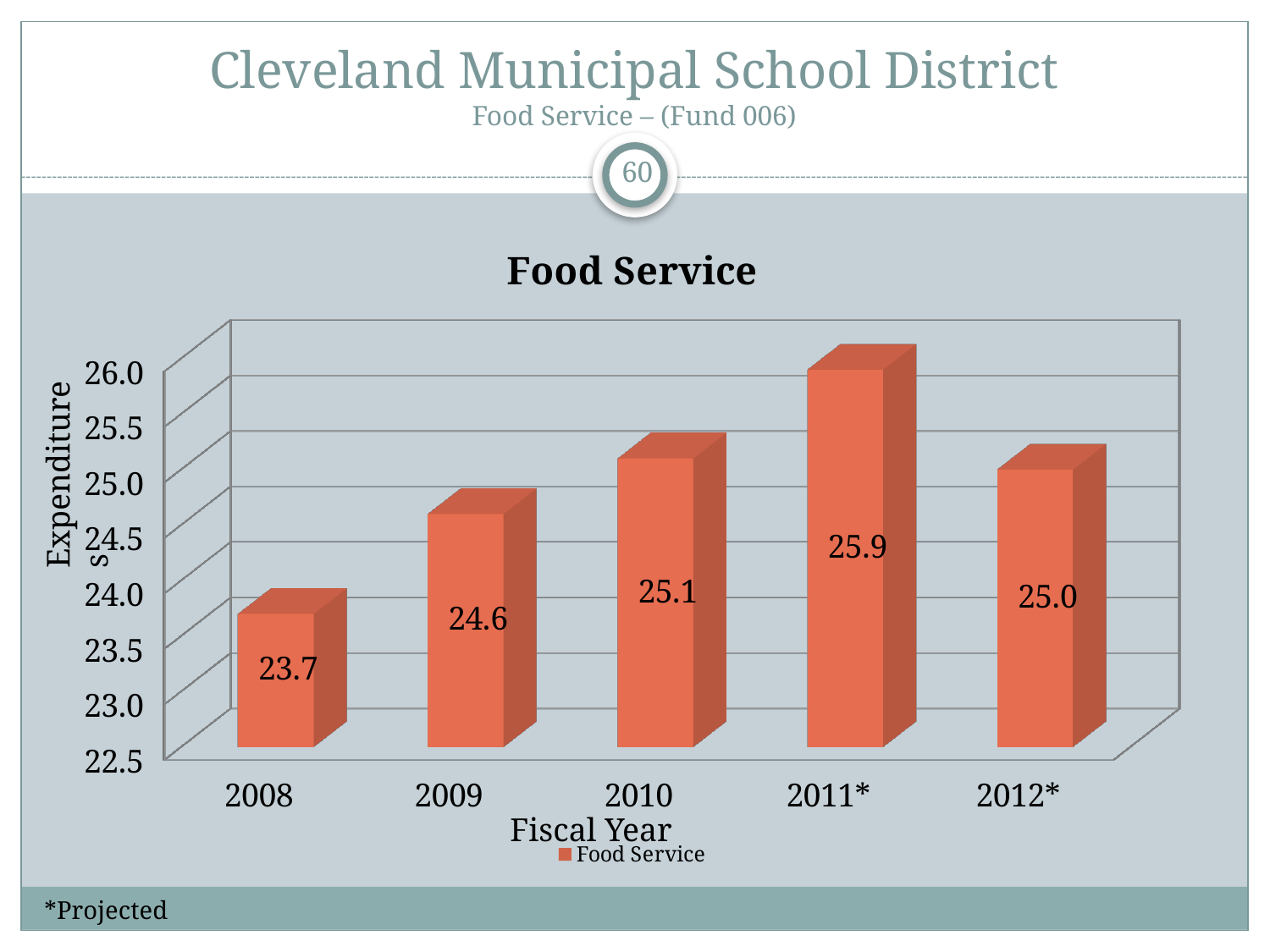
What kind of chart is used to show Food Service expenditure? bar chart What is the difference between the Food Service expenditure in 2009 and in 2010? 0.5 Which fiscal year has the lowest Food Service expenditure? 2008 How many fiscal years are shown on the chart? 5 What is the difference between the Food Service expenditure in 2011* and in 2008? 2.2 Which fiscal year has the highest Food Service expenditure? 2011* Is the Food Service expenditure for 2011* greater or less than 25.5? greater Which fiscal year has a larger Food Service expenditure, 2009 or 2012*? 2012* What is the title of the chart? Food Service What is the Food Service expenditure for fiscal year 2008? 23.7 What is the projected Food Service expenditure for fiscal year 2012*? 25.0 What is the Food Service expenditure for fiscal year 2010? 25.1